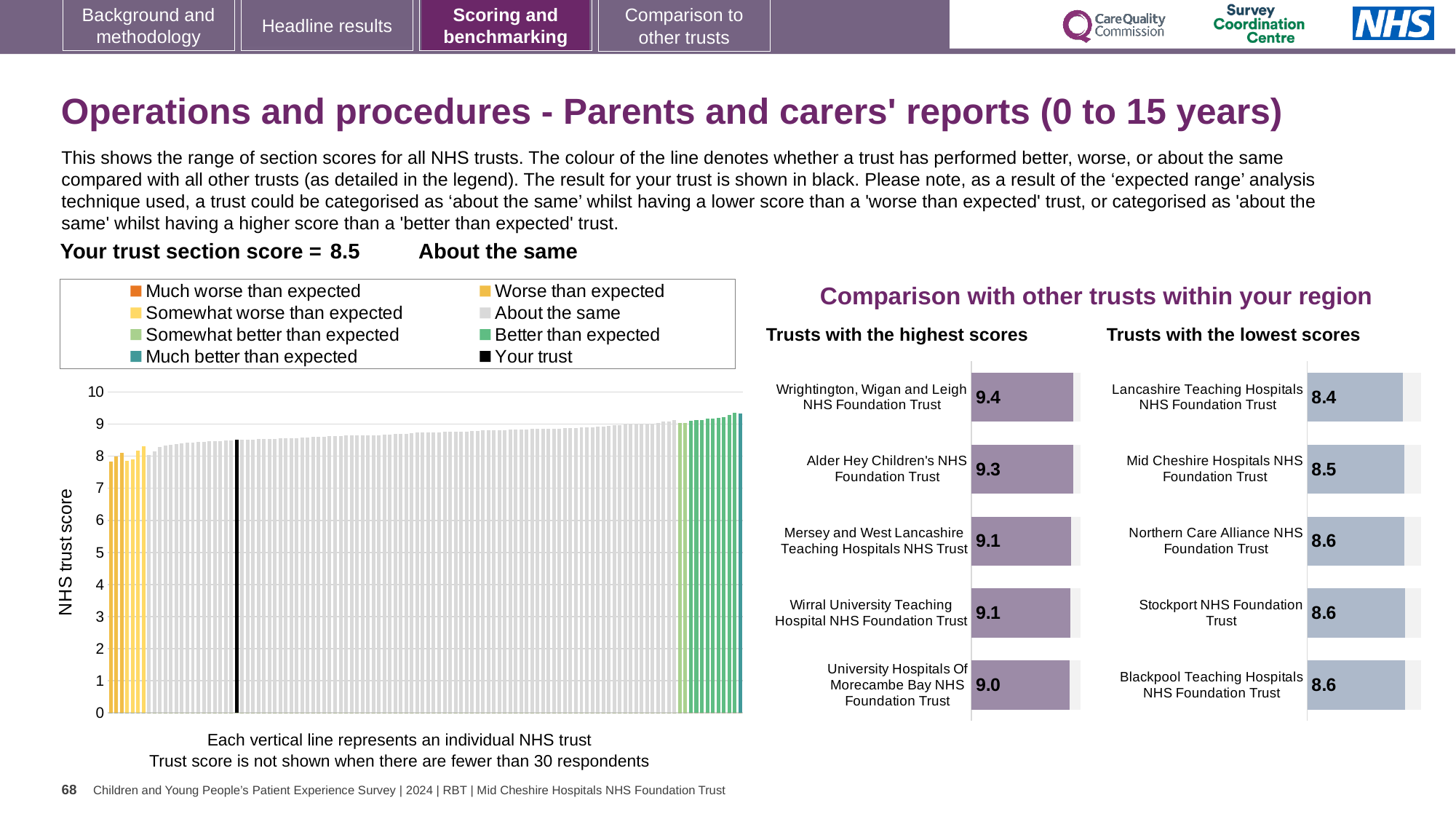
What kind of chart is the large chart on the left with the y-axis labelled 'NHS trust score'? Bar chart How many trusts are shown in the 'Trusts with the lowest scores' chart? 5 In the 'Trusts with the lowest scores' chart, which trust has the lowest score? Lancashire Teaching Hospitals NHS Foundation Trust In the 'Trusts with the highest scores' chart, which trust has the highest score? Wrightington, Wigan and Leigh NHS Foundation Trust In the 'Trusts with the lowest scores' chart, what is the difference between the scores of Mid Cheshire Hospitals NHS Foundation Trust and Lancashire Teaching Hospitals NHS Foundation Trust? 0.1 In the 'Trusts with the highest scores' chart, what is the score for University Hospitals Of Morecambe Bay NHS Foundation Trust? 9.0 In the 'Trusts with the lowest scores' chart, what is the score for Lancashire Teaching Hospitals NHS Foundation Trust? 8.4 How many entries does the legend above the large chart on the left list? 8 In the 'Trusts with the highest scores' chart, which has the larger score: Alder Hey Children's NHS Foundation Trust or Mersey and West Lancashire Teaching Hospitals NHS Trust? Alder Hey Children's NHS Foundation Trust In the large chart on the left, is the value of the black bar (Your trust) greater or less than 8? greater In the 'Trusts with the highest scores' chart, what is the score for Wrightington, Wigan and Leigh NHS Foundation Trust? 9.4 In the 'Trusts with the highest scores' chart, what is the difference between the scores of Wrightington, Wigan and Leigh NHS Foundation Trust and University Hospitals Of Morecambe Bay NHS Foundation Trust? 0.4